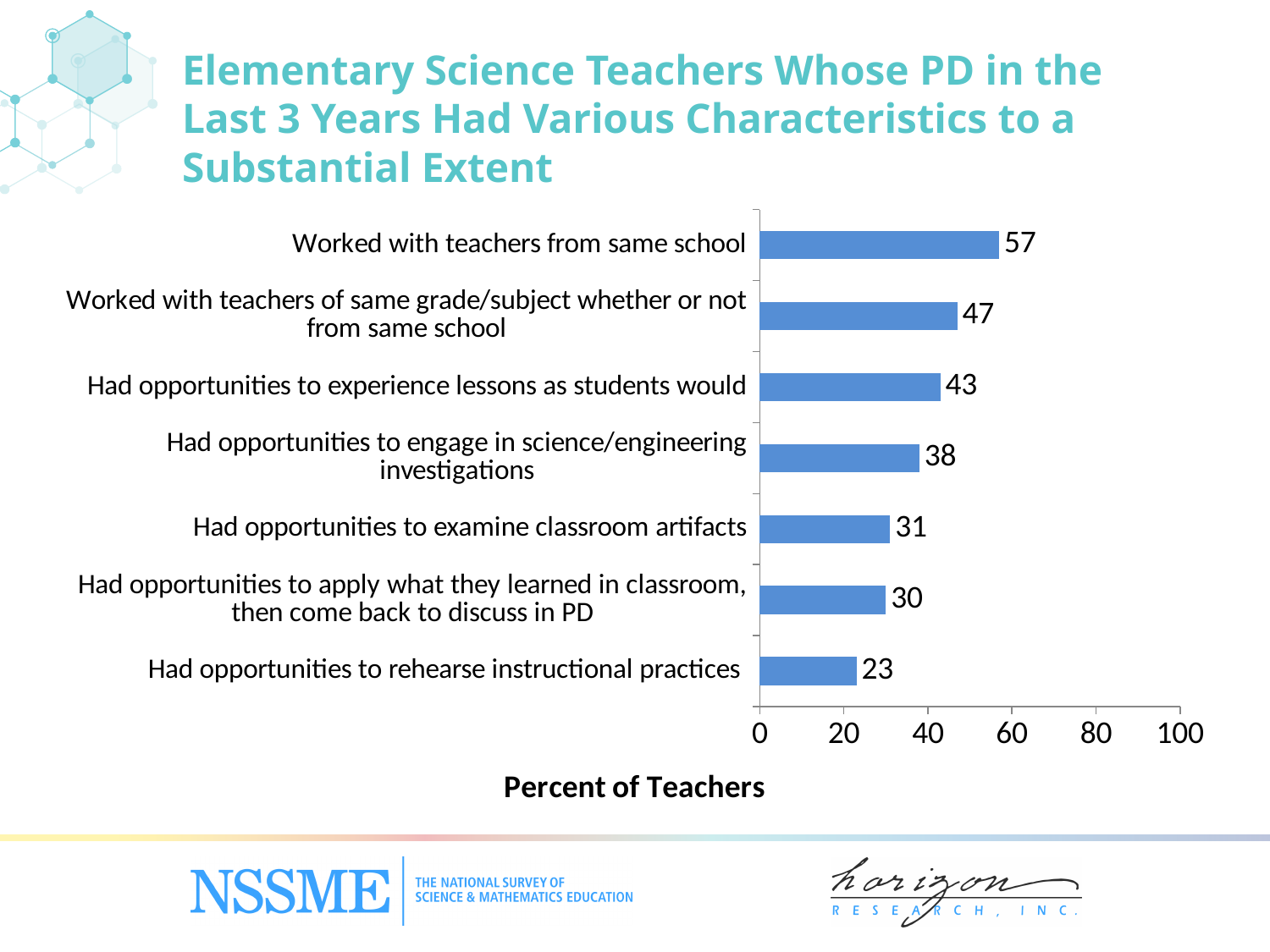
Which characteristic has the lowest percent of teachers? Had opportunities to rehearse instructional practices What kind of chart is shown on the slide? bar chart What percent of teachers worked with teachers from the same school? 57 What is the difference between 'Worked with teachers from same school' and 'Had opportunities to rehearse instructional practices'? 34 What is the label of the horizontal axis? Percent of Teachers What is the value for 'Had opportunities to engage in science/engineering investigations'? 38 Is the value for 'Had opportunities to experience lessons as students would' greater or less than 40? greater What is the value for 'Had opportunities to rehearse instructional practices'? 23 What is the difference between 'Worked with teachers of same grade/subject whether or not from same school' and 'Had opportunities to experience lessons as students would'? 4 Which is larger: 'Had opportunities to examine classroom artifacts' or 'Had opportunities to engage in science/engineering investigations'? Had opportunities to engage in science/engineering investigations How many characteristics are shown in the chart? 7 Which characteristic has the highest percent of teachers? Worked with teachers from same school